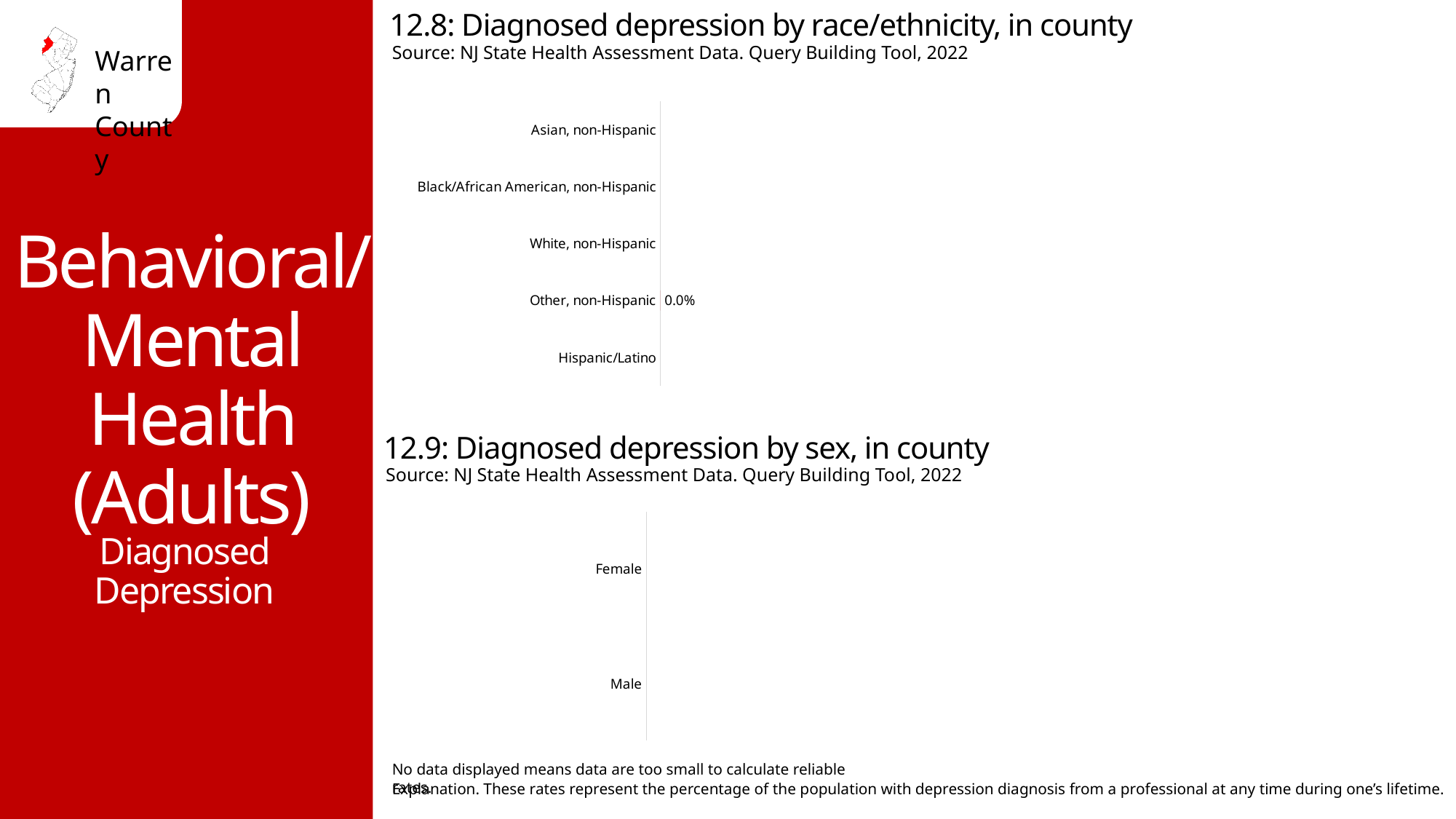
How many race/ethnicity categories are listed on the axis of the chart '12.8: Diagnosed depression by race/ethnicity, in county'? 5 What are the two categories listed on the chart '12.9: Diagnosed depression by sex, in county'? Female and Male In the chart '12.8: Diagnosed depression by race/ethnicity, in county', which category appears at the top of the axis? Asian, non-Hispanic How many categories are listed on the axis of the chart '12.9: Diagnosed depression by sex, in county'? 2 In the chart '12.8: Diagnosed depression by race/ethnicity, in county', what value is shown for Other, non-Hispanic? 0.0% In the chart '12.8: Diagnosed depression by race/ethnicity, in county', which category is the only one with a printed data label? Other, non-Hispanic In the chart '12.8: Diagnosed depression by race/ethnicity, in county', which category appears at the bottom of the axis? Hispanic/Latino